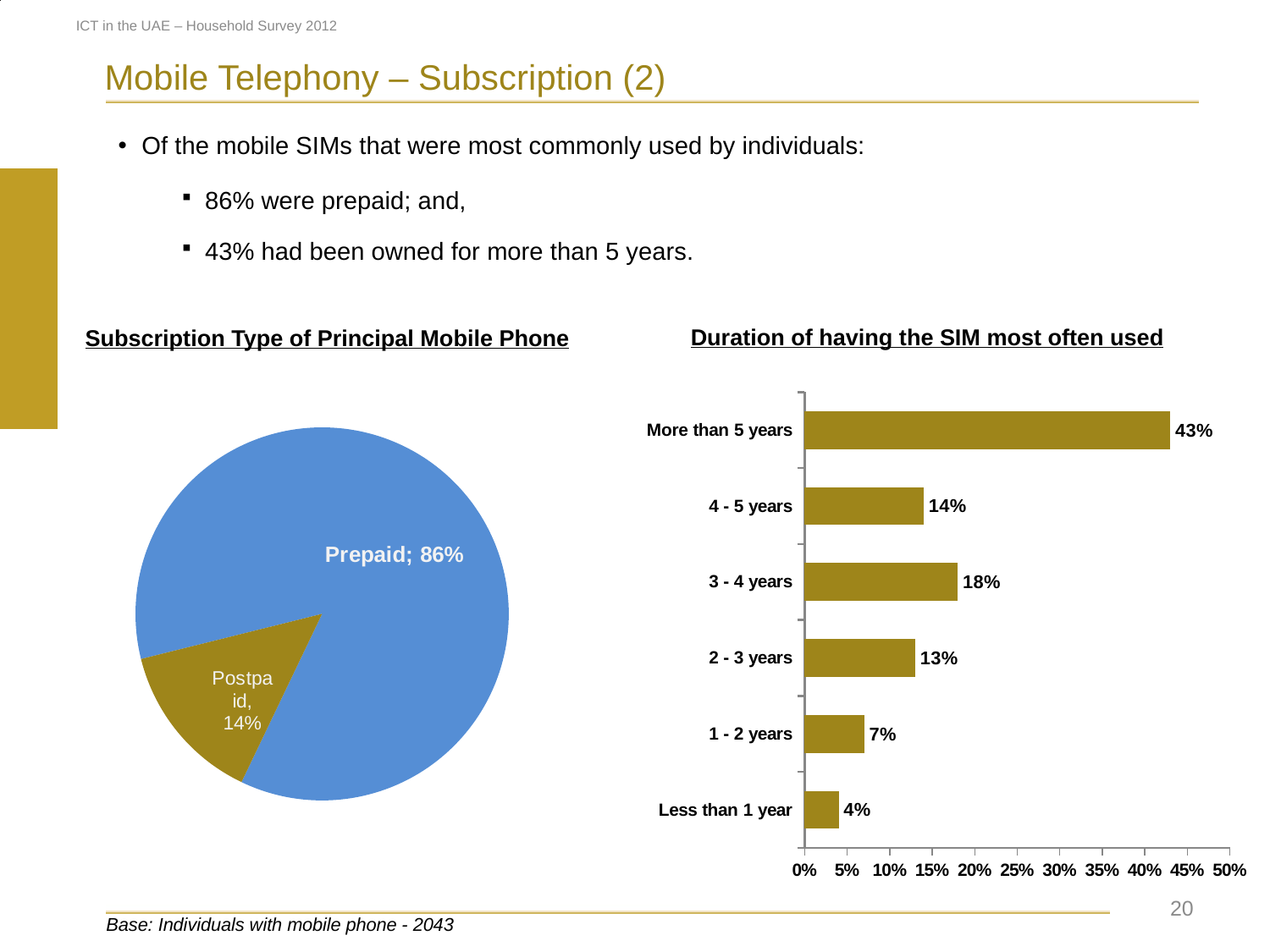
In the 'Subscription Type of Principal Mobile Phone' chart, how many slices does the pie have? 2 In the 'Duration of having the SIM most often used' chart, what is the value for '3 - 4 years'? 18% In the 'Duration of having the SIM most often used' chart, what is the difference between the values for 'More than 5 years' and '4 - 5 years'? 29% What kind of chart is the 'Duration of having the SIM most often used' chart? Bar chart In the 'Duration of having the SIM most often used' chart, which category has the highest value? More than 5 years In the 'Duration of having the SIM most often used' chart, which is larger: the value for '2 - 3 years' or '1 - 2 years'? 2 - 3 years In the 'Subscription Type of Principal Mobile Phone' chart, what share of principal mobile phones are postpaid? 14% How many categories are shown in the 'Duration of having the SIM most often used' chart? 6 What kind of chart is the 'Subscription Type of Principal Mobile Phone' chart? Pie chart In the 'Subscription Type of Principal Mobile Phone' chart, what share of principal mobile phones are prepaid? 86% In the 'Duration of having the SIM most often used' chart, which category has the lowest value? Less than 1 year In the 'Duration of having the SIM most often used' chart, what is the value for 'More than 5 years'? 43%